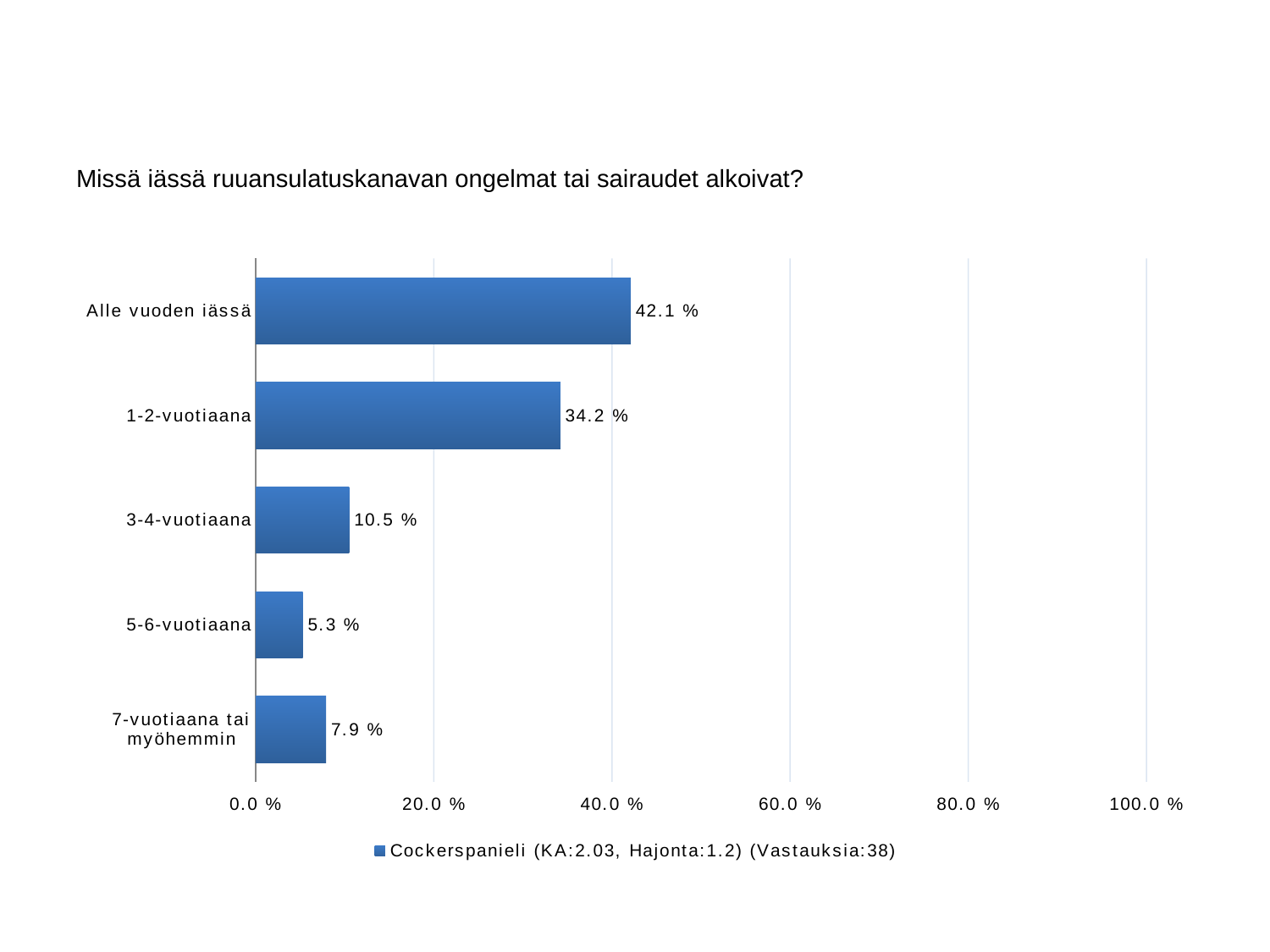
What is the difference between the values for "Alle vuoden iässä" and "1-2-vuotiaana"? 7.9 % What is the value for "7-vuotiaana tai myöhemmin"? 7.9 % What is the title of the chart? Missä iässä ruuansulatuskanavan ongelmat tai sairaudet alkoivat? How many categories are shown in the chart? 5 Is the value for "1-2-vuotiaana" greater or less than 40.0 %? less How many series does the legend list? 1 What is the value for "3-4-vuotiaana"? 10.5 % Which is larger, the value for "5-6-vuotiaana" or "7-vuotiaana tai myöhemmin"? 7-vuotiaana tai myöhemmin Which category has the lowest value? 5-6-vuotiaana What is the value for "Alle vuoden iässä"? 42.1 % What kind of chart is shown on the slide? bar chart Which category has the highest value? Alle vuoden iässä